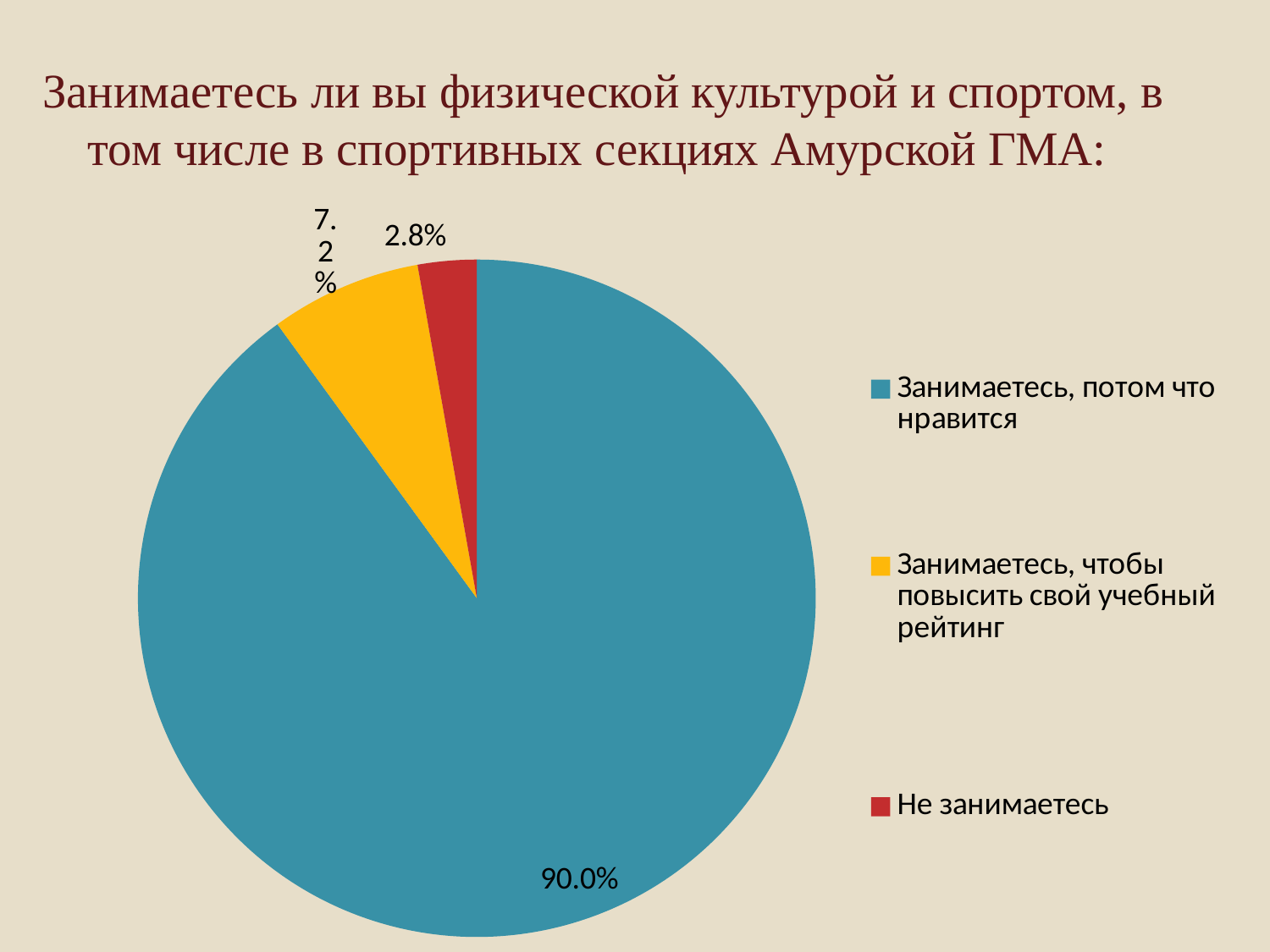
Which category has the smallest slice of the pie? Не занимаетесь Which slice is larger: "Занимаетесь, чтобы повысить свой учебный рейтинг" or "Не занимаетесь"? Занимаетесь, чтобы повысить свой учебный рейтинг What share of the pie is labelled "Не занимаетесь"? 2.8% What is the difference in percentage points between the "Занимаетесь, чтобы повысить свой учебный рейтинг" slice and the "Не занимаетесь" slice? 4.4% How many entries does the legend list? 3 Which category has the largest slice of the pie? Занимаетесь, потом что нравится What share of the pie is labelled "Занимаетесь, потом что нравится"? 90.0% What colour is the slice for "Занимаетесь, чтобы повысить свой учебный рейтинг"? yellow What share of the pie is labelled "Занимаетесь, чтобы повысить свой учебный рейтинг"? 7.2% What colour is the slice for "Не занимаетесь"? red What kind of chart is shown on the slide? pie chart How many slices does the pie chart have? 3